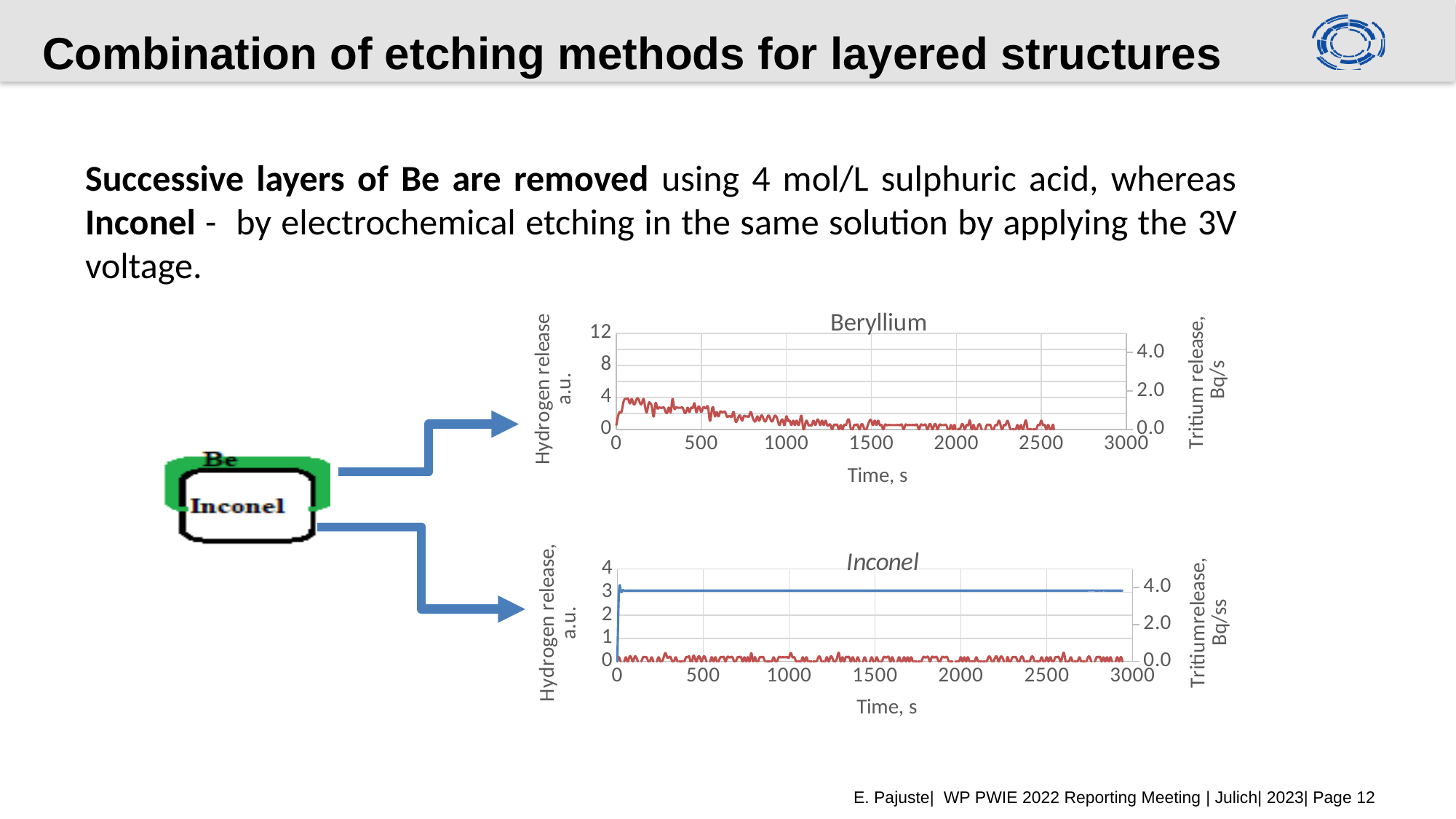
In the Beryllium chart, is the peak of the red line greater or less than 8 on the left axis? less What is the highest tick value on the left y axis of the Beryllium chart? 12 In the Inconel chart, is the red line greater or less than 1 on the left axis? less In the Beryllium chart, does the red line rise or fall along the x axis after its early peak? fall In the Inconel chart, is the flat blue line greater or less than 2 on the left axis? greater In the Inconel chart, which line is higher, the blue line or the red line? blue line What is the highest tick value on the x axis of the Beryllium chart? 3000 How many charts are shown on the slide? 2 What kind of chart is the Inconel chart? line chart What kind of chart is the Beryllium chart? line chart What is the title of the top chart? Beryllium What is the title of the bottom chart? Inconel